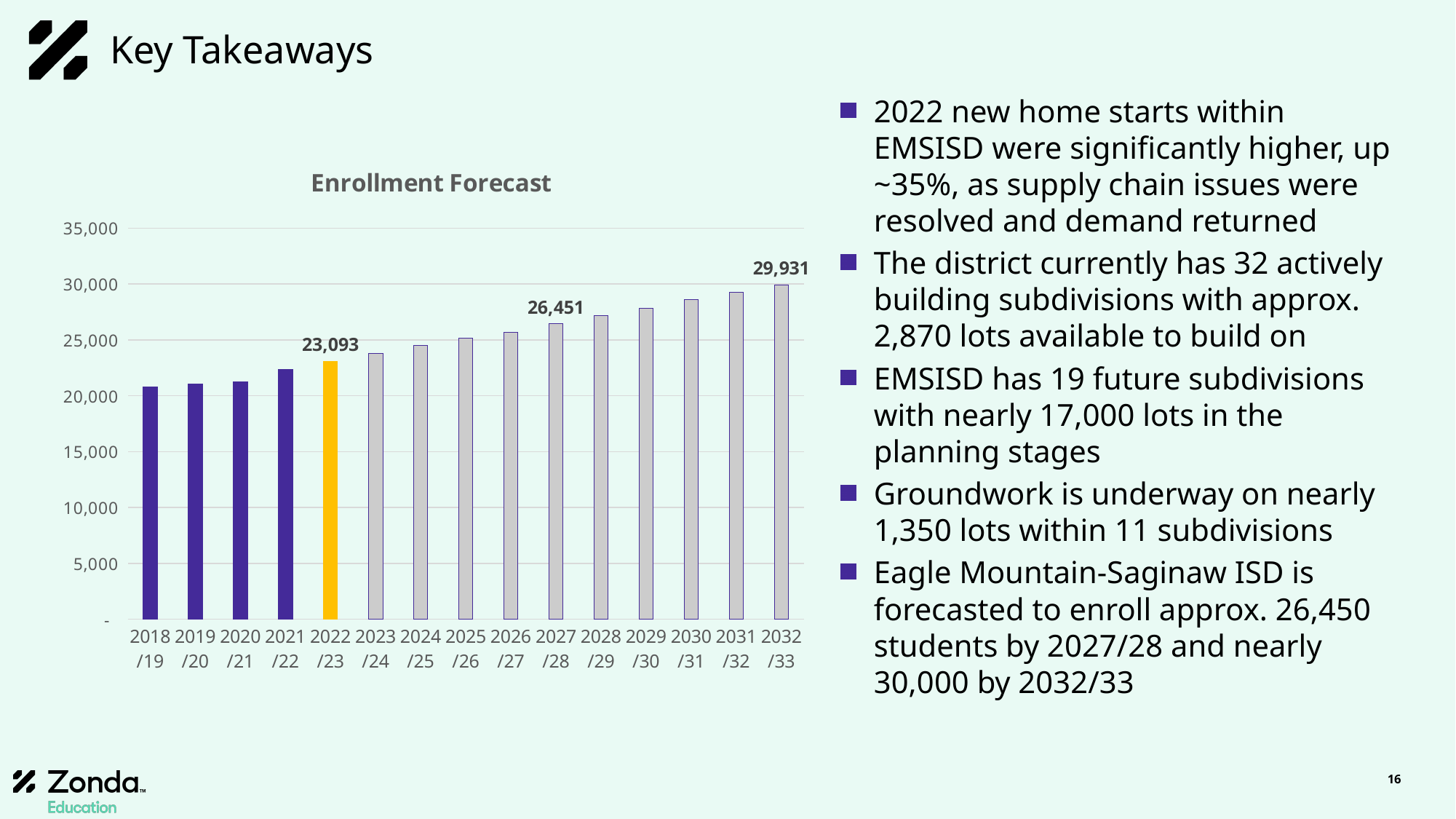
What is the title of the chart? Enrollment Forecast Is the enrollment value for 2018/19 greater or less than 25,000? less How many years are shown on the x axis of the chart? 15 Do enrollment values rise or fall from 2018/19 to 2032/33? rise What is the difference in enrollment between 2032/33 and 2027/28? 3,480 What is the difference in enrollment between 2027/28 and 2022/23? 3,358 What is the forecasted enrollment for 2032/33? 29,931 Which year has the lowest enrollment in the chart? 2018/19 What type of chart is shown on the slide? bar chart What is the forecasted enrollment for 2022/23? 23,093 Which year has the highest enrollment in the chart? 2032/33 What is the forecasted enrollment for 2027/28? 26,451